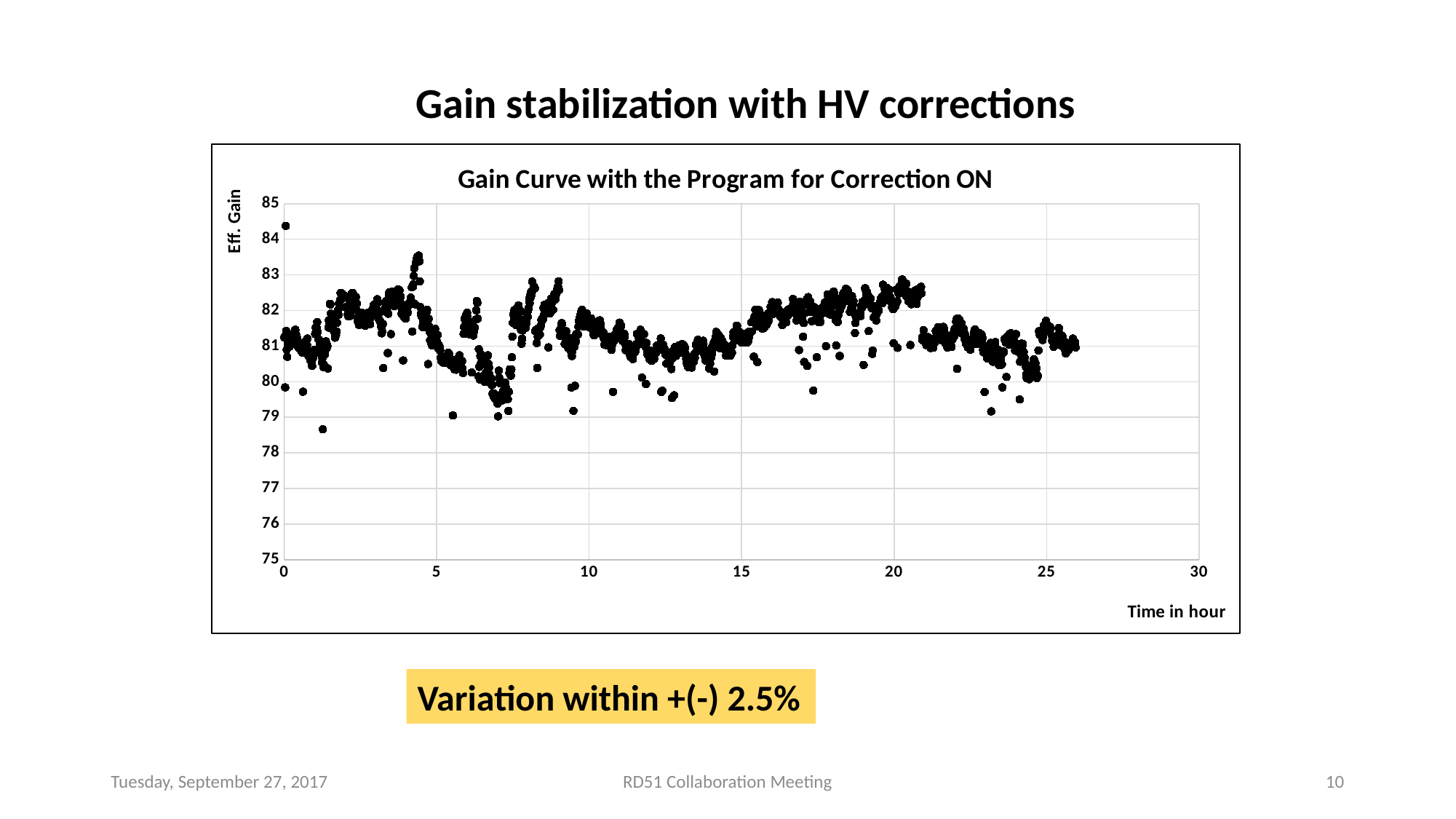
What is the title of the chart? Gain Curve with the Program for Correction ON Around 13 hours, are the plotted values greater or less than 82? less What is the highest tick value shown on the vertical axis? 85 Around 20 hours, are most of the plotted values greater or less than 82? greater Are all plotted values in the chart greater or less than 78? greater What kind of chart is shown on the slide? scatter plot What is the label of the vertical axis of the chart? Eff. Gain Over the full time range, do the plotted values show a strong rise, a strong fall, or stay roughly stable? roughly stable